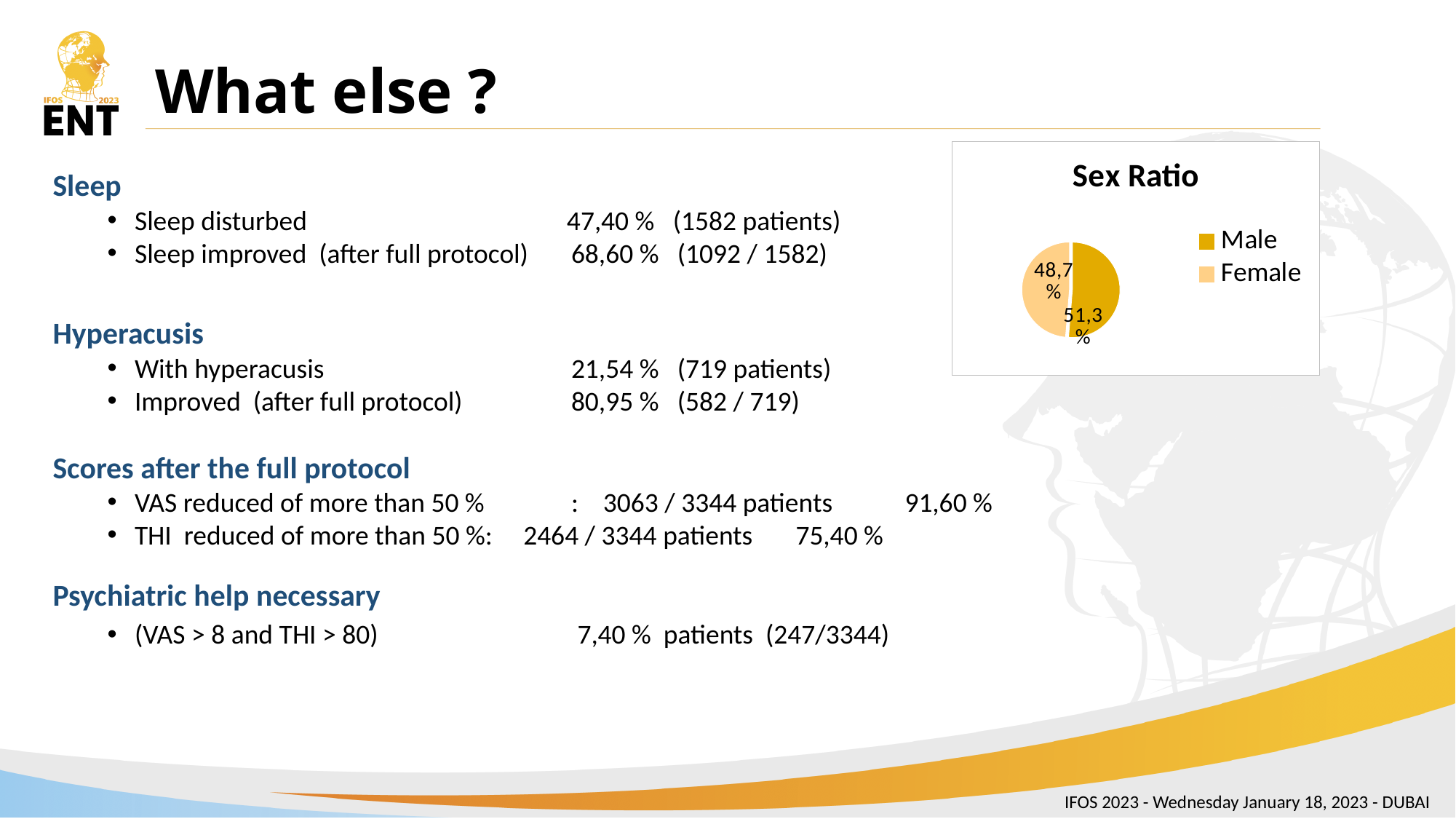
In the Sex Ratio chart, which category is shown in the darker gold colour? Male In the Sex Ratio chart, which category has the smaller share? Female How many entries does the legend of the Sex Ratio chart list? 2 In the Sex Ratio chart, which category has the larger share? Male How many categories does the Sex Ratio pie chart show? 2 In the Sex Ratio chart, is the Male share greater or less than 50 %? greater In the Sex Ratio chart, what share is shown for Male? 51,3 % In the Sex Ratio chart, what is the difference in percentage points between the Male and Female shares? 2,6 % What kind of chart is the Sex Ratio chart? pie chart What is the title of the chart on the slide? Sex Ratio In the Sex Ratio chart, is the Male share larger or smaller than the Female share? larger In the Sex Ratio chart, what share is shown for Female? 48,7 %